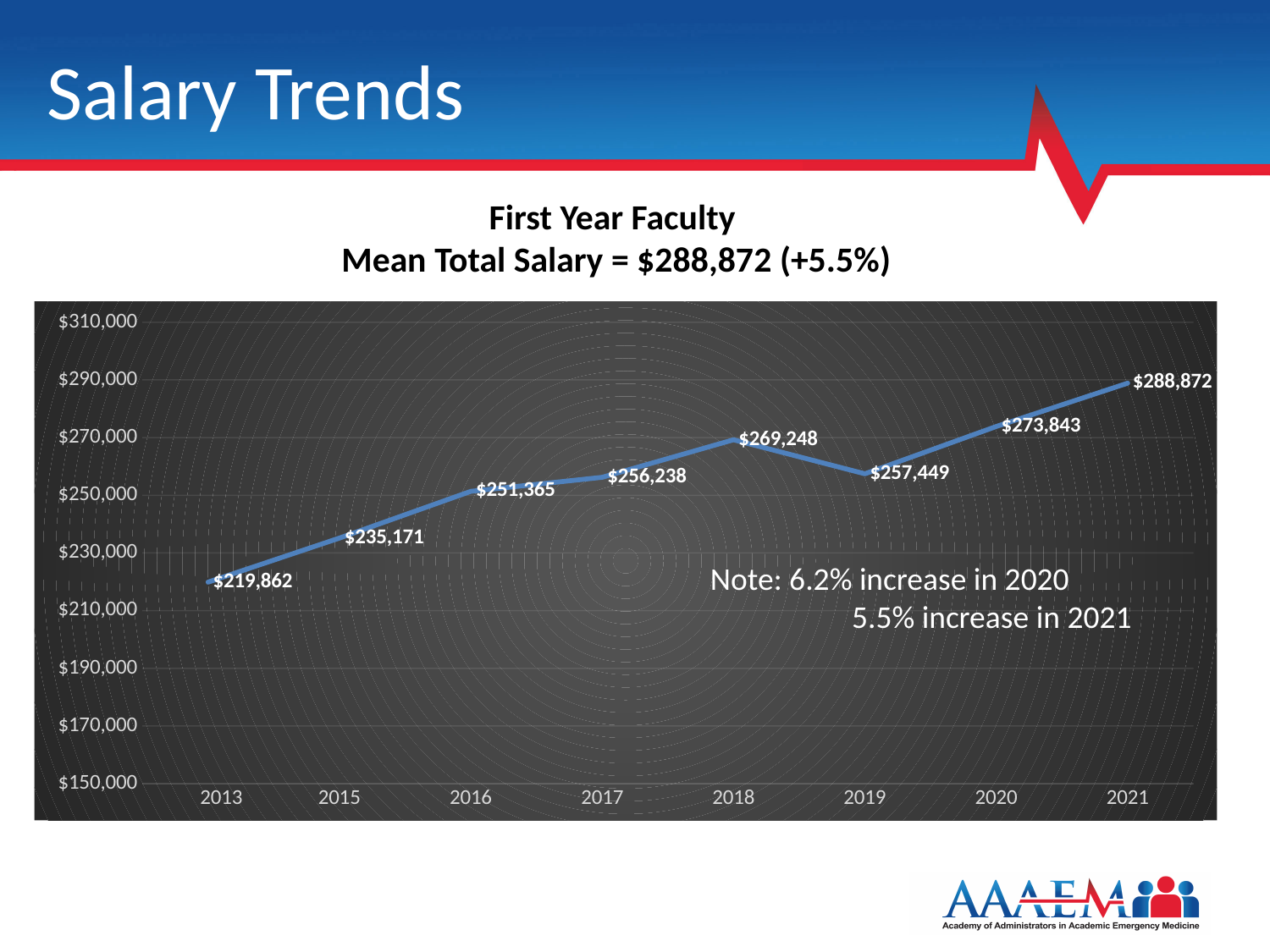
Which year has the lowest mean total salary on the chart? 2013 What is the mean total salary for first year faculty in 2018? $269,248 By how much did the mean total salary drop from 2018 to 2019? $11,799 What is the mean total salary for first year faculty in 2016? $251,365 How much higher is the 2021 mean total salary than the 2020 value? $15,029 Does the mean total salary generally rise or fall from 2013 to 2021? Rise What kind of chart is shown on the slide? Line chart What is the mean total salary for first year faculty in 2020? $273,843 Which year has a higher mean total salary, 2018 or 2019? 2018 Which year has the highest mean total salary on the chart? 2021 What is the mean total salary for first year faculty in 2013? $219,862 How many years are plotted on the chart? 8